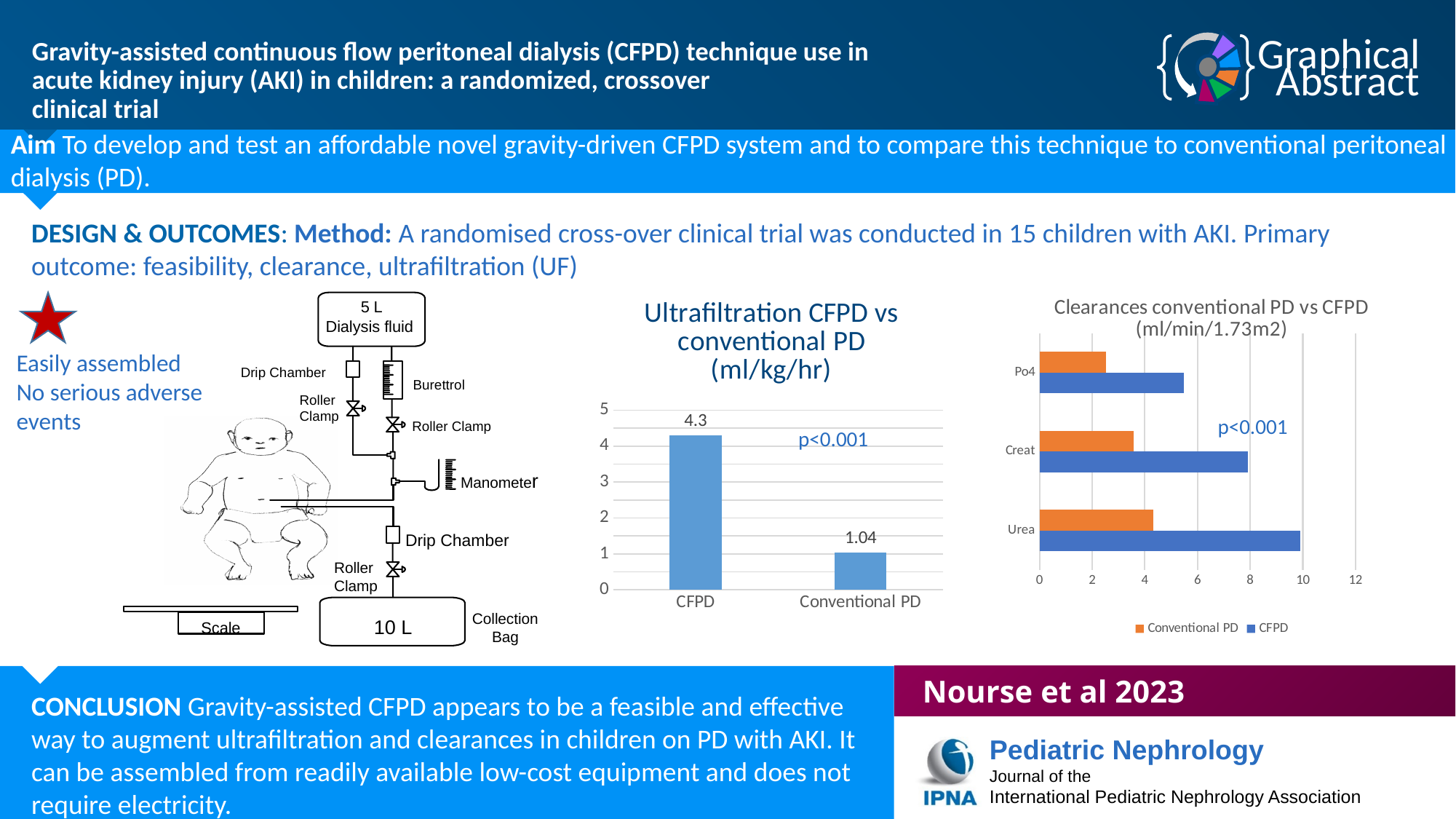
In the Clearances conventional PD vs CFPD chart, how many series does the legend list? 2 What type of chart is the Ultrafiltration CFPD vs conventional PD chart? Bar chart In the Ultrafiltration CFPD vs conventional PD chart, which category has the higher value? CFPD In the Clearances conventional PD vs CFPD chart, is the CFPD value for Urea greater or less than 8? greater In the Clearances conventional PD vs CFPD chart, which category has the highest CFPD clearance? Urea In the Clearances conventional PD vs CFPD chart, which colour represents the Conventional PD series? Orange In the Ultrafiltration CFPD vs conventional PD chart, how many categories are plotted? 2 In the Clearances conventional PD vs CFPD chart, how many categories are shown on the vertical axis? 3 In the Ultrafiltration CFPD vs conventional PD chart, what is the difference between the CFPD and Conventional PD values? 3.26 In the Clearances conventional PD vs CFPD chart, is the Conventional PD value for Po4 greater or less than 4? less In the Ultrafiltration CFPD vs conventional PD chart, what is the value for Conventional PD? 1.04 In the Ultrafiltration CFPD vs conventional PD chart, what is the value for CFPD? 4.3